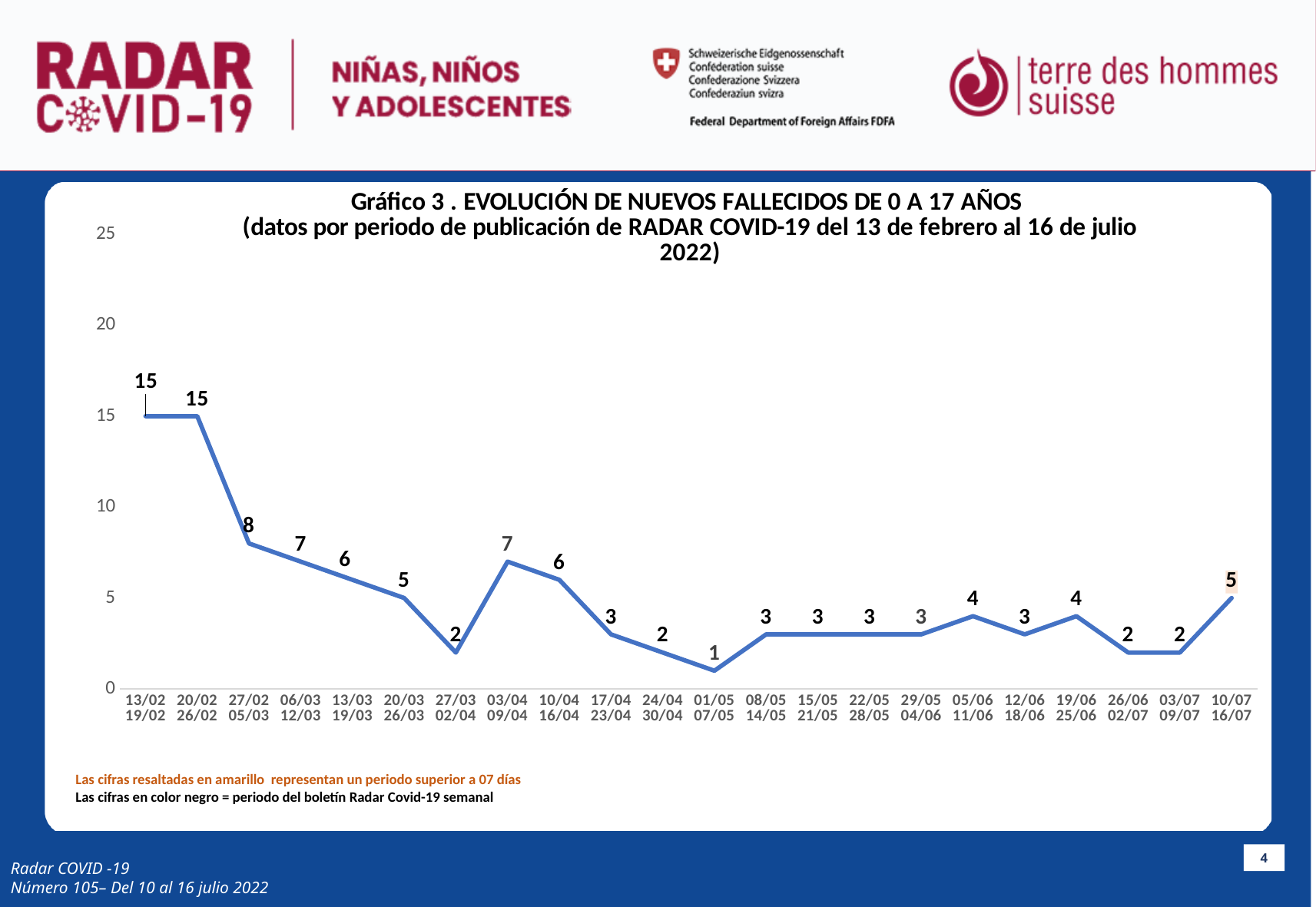
How many periods (data points) are plotted on the chart? 22 Which is larger, the value for 05/06–11/06 or the value for 12/06–18/06? 05/06–11/06 What is the value for the period 27/02–05/03? 8 According to the note below the chart, what do the figures highlighted in yellow represent? un periodo superior a 07 días What type of chart is shown on the slide? line chart Overall, do the values rise or fall from the first period to the last period? fall Which period has the lowest value? 01/05–07/05 What is the value for the period 03/04–09/04? 7 What is the highest value shown on the vertical axis? 25 What is the value for the last period, 10/07–16/07? 5 What is the difference between the value for 20/02–26/02 and the value for 27/02–05/03? 7 What is the value for the period 13/02–19/02? 15